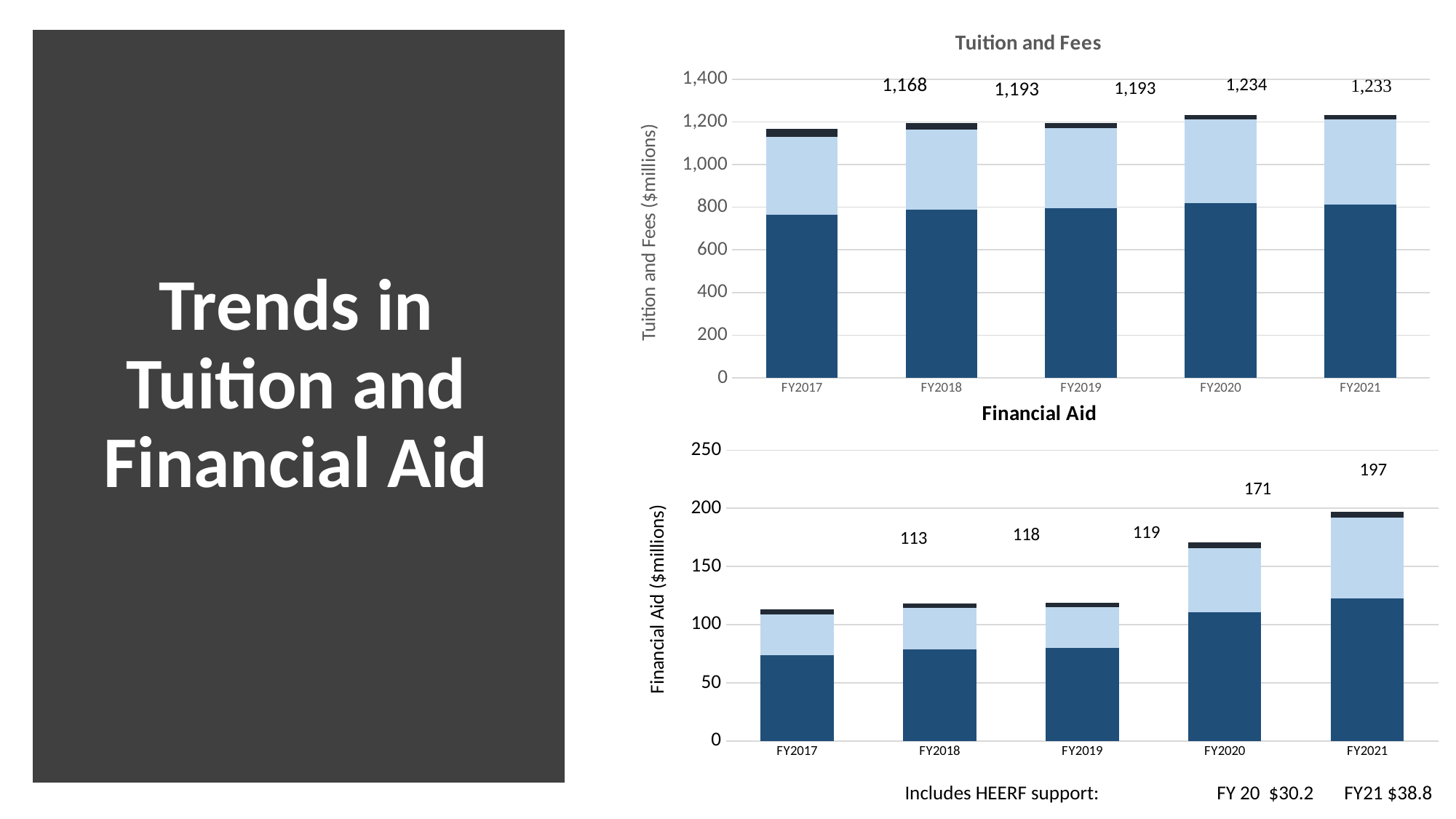
What is the y-axis label of the Tuition and Fees chart? Tuition and Fees ($millions) On the Tuition and Fees chart, what is the total value for FY2021? 1,233 On the Tuition and Fees chart, is the total for FY2017 greater or less than 1,200? less What kind of chart is the Tuition and Fees chart? Stacked bar chart On the Financial Aid chart, what is the difference between the FY2021 and FY2020 totals? 26 On the Financial Aid chart, what is the total value for FY2021? 197 On the Financial Aid chart, what is the total value for FY2020? 171 On the Financial Aid chart, do the totals generally rise or fall from FY2017 to FY2021? rise On the Tuition and Fees chart, which is larger, the total for FY2020 or FY2017? FY2020 On the Financial Aid chart, which fiscal year has the lowest total? FY2017 How many fiscal years are shown on the Financial Aid chart? 5 On the Financial Aid chart, which fiscal year has the highest total? FY2021